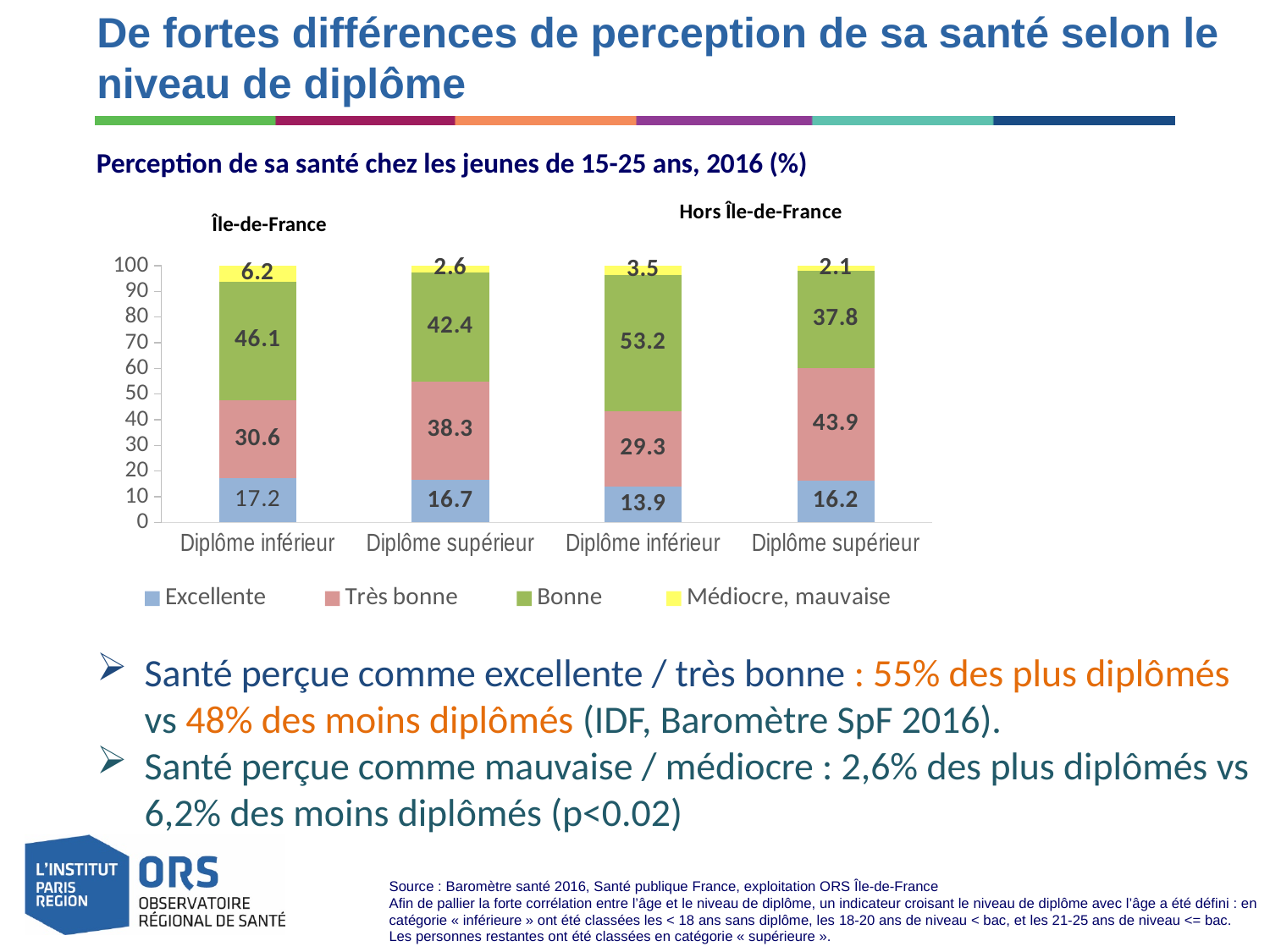
Which bar has the highest value for "Bonne"? Diplôme inférieur (Hors Île-de-France) How many bars are shown in the chart? 4 Which bar has the lowest value for "Médiocre, mauvaise"? Diplôme supérieur (Hors Île-de-France) What is the difference between the "Très bonne" values for Diplôme supérieur and Diplôme inférieur in Île-de-France? 7.7 What is the value of "Bonne" for Diplôme inférieur in Île-de-France? 46.1 What is the value of "Médiocre, mauvaise" for Diplôme supérieur in Île-de-France? 2.6 How many series does the legend list? 4 What is the value of "Excellente" for Diplôme inférieur in Hors Île-de-France? 13.9 What is the value of "Très bonne" for Diplôme supérieur in Hors Île-de-France? 43.9 Which is larger: the "Excellente" value for Diplôme inférieur in Île-de-France or for Diplôme supérieur in Île-de-France? Diplôme inférieur (Île-de-France) What kind of chart is shown on the slide? Stacked bar chart What is the title of the chart? Perception de sa santé chez les jeunes de 15-25 ans, 2016 (%)